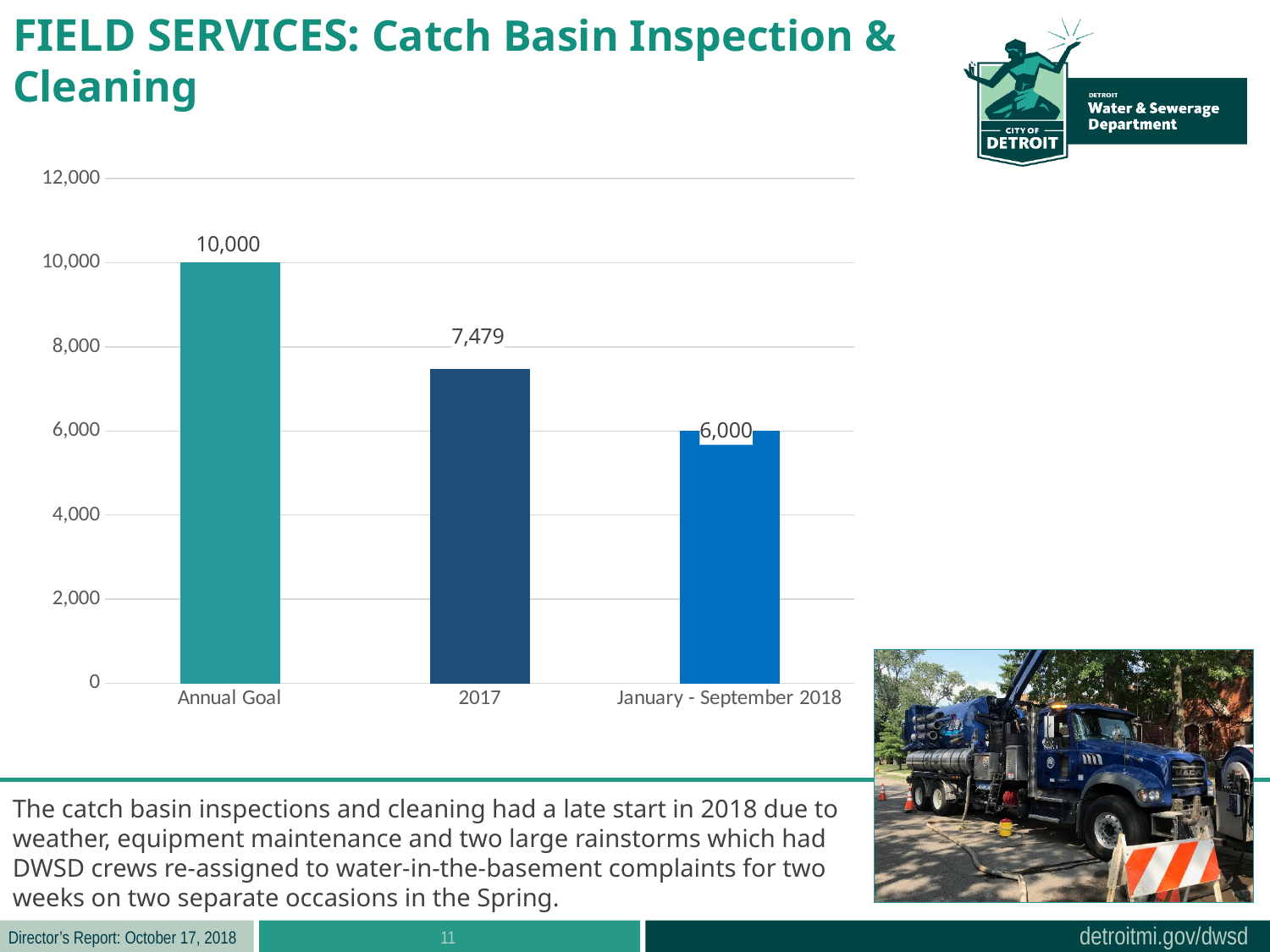
Which is larger, the value for 2017 or the value for January - September 2018? 2017 What is the value for 2017? 7,479 What is the difference between the 2017 value and the January - September 2018 value? 1,479 What kind of chart is shown on the slide? bar chart What is the difference between the Annual Goal and the 2017 value? 2,521 Do the values rise or fall from left to right along the x axis? fall Is the value for 2017 greater or less than 8,000? less What is the value for Annual Goal? 10,000 What is the value for January - September 2018? 6,000 Which category has the highest value? Annual Goal How many categories are shown on the chart? 3 Which category has the lowest value? January - September 2018